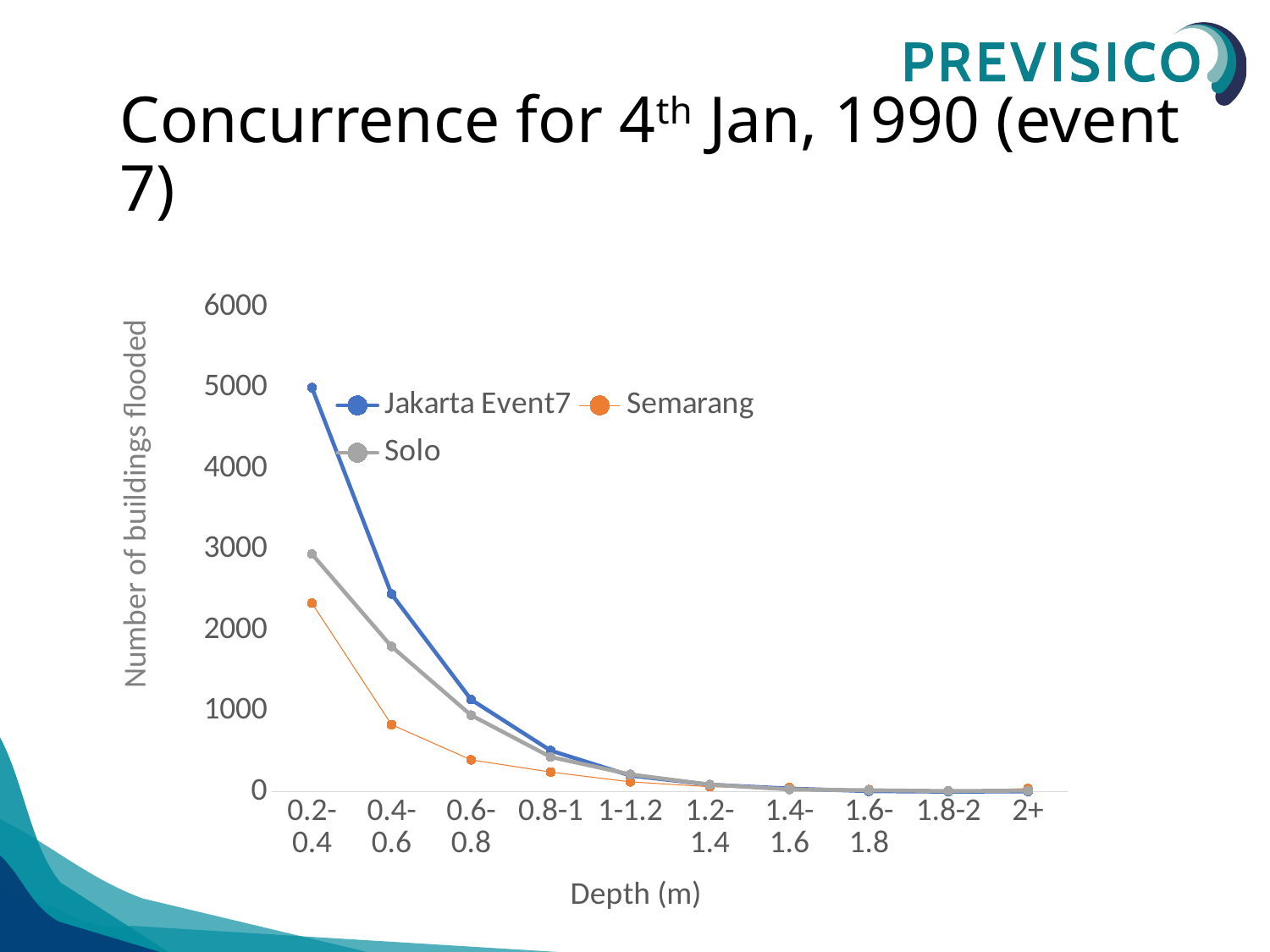
Which series has the lowest value at depth 0.4-0.6? Semarang What kind of chart is shown on the slide? line chart How many series does the legend list? 3 Is the value for Solo at depth 0.2-0.4 greater or less than 2000? greater How many depth categories are shown on the x axis? 10 Is the value for Semarang at depth 0.4-0.6 greater or less than 1000? less For Jakarta Event7, which depth category has the highest value? 0.2-0.4 What is the title of the y axis? Number of buildings flooded Is the value for Jakarta Event7 at depth 0.2-0.4 greater or less than 4000? greater At depth 0.6-0.8, which is larger: Solo or Semarang? Solo Which series has the highest value at depth 0.2-0.4? Jakarta Event7 Do the values for Jakarta Event7 rise or fall as depth increases along the x axis? fall